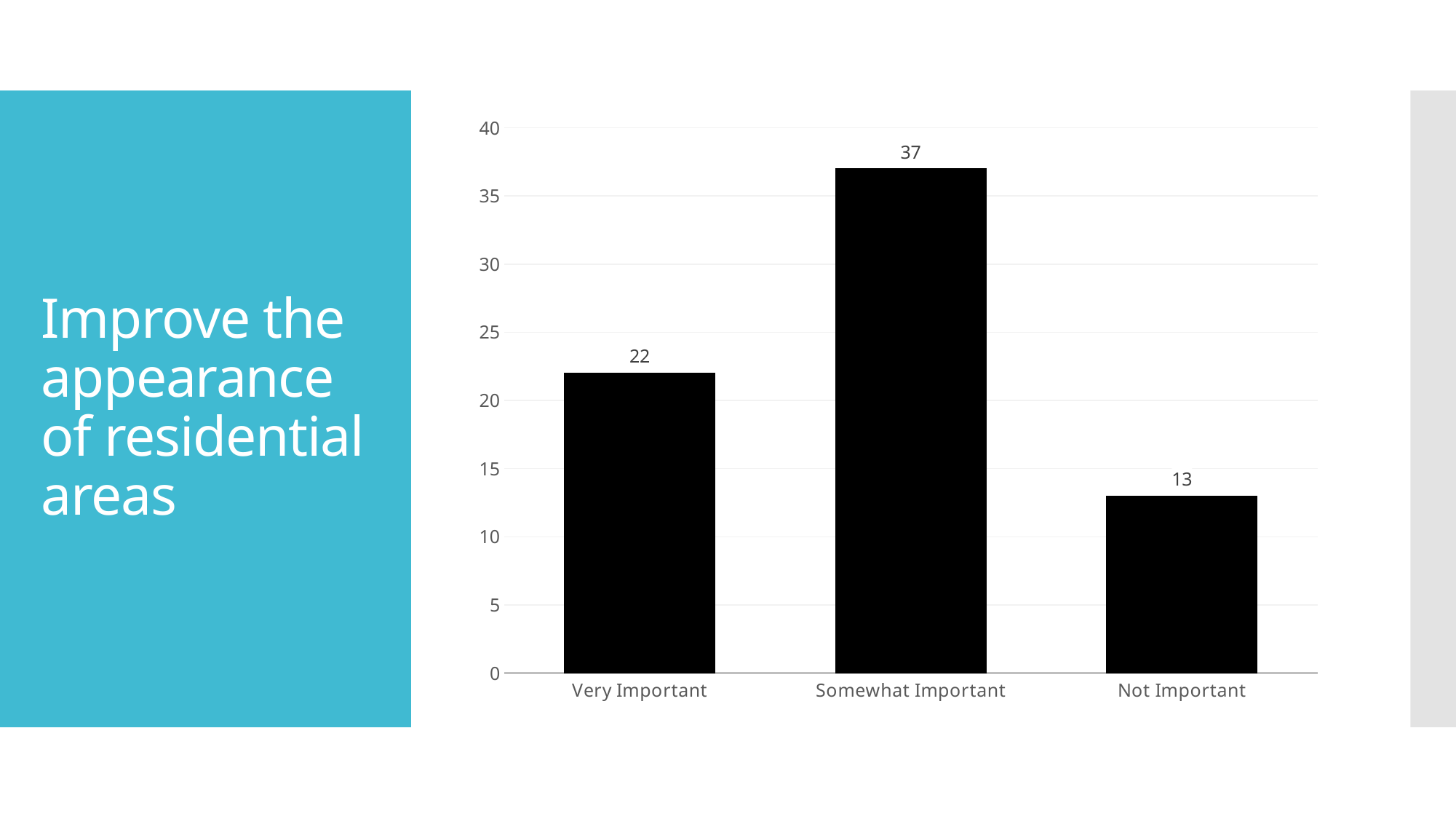
How many categories are shown on the x axis? 3 What is the value for Somewhat Important? 37 What is the difference between the values for Very Important and Not Important? 9 What is the title text on the slide next to the chart? Improve the appearance of residential areas Is the value for Somewhat Important greater or less than 35? greater Which is larger, the value for Very Important or the value for Not Important? Very Important What is the value for Not Important? 13 What is the value for Very Important? 22 What kind of chart is shown on the slide? bar chart Which category has the highest value? Somewhat Important What is the difference between the values for Somewhat Important and Very Important? 15 Which category has the lowest value? Not Important